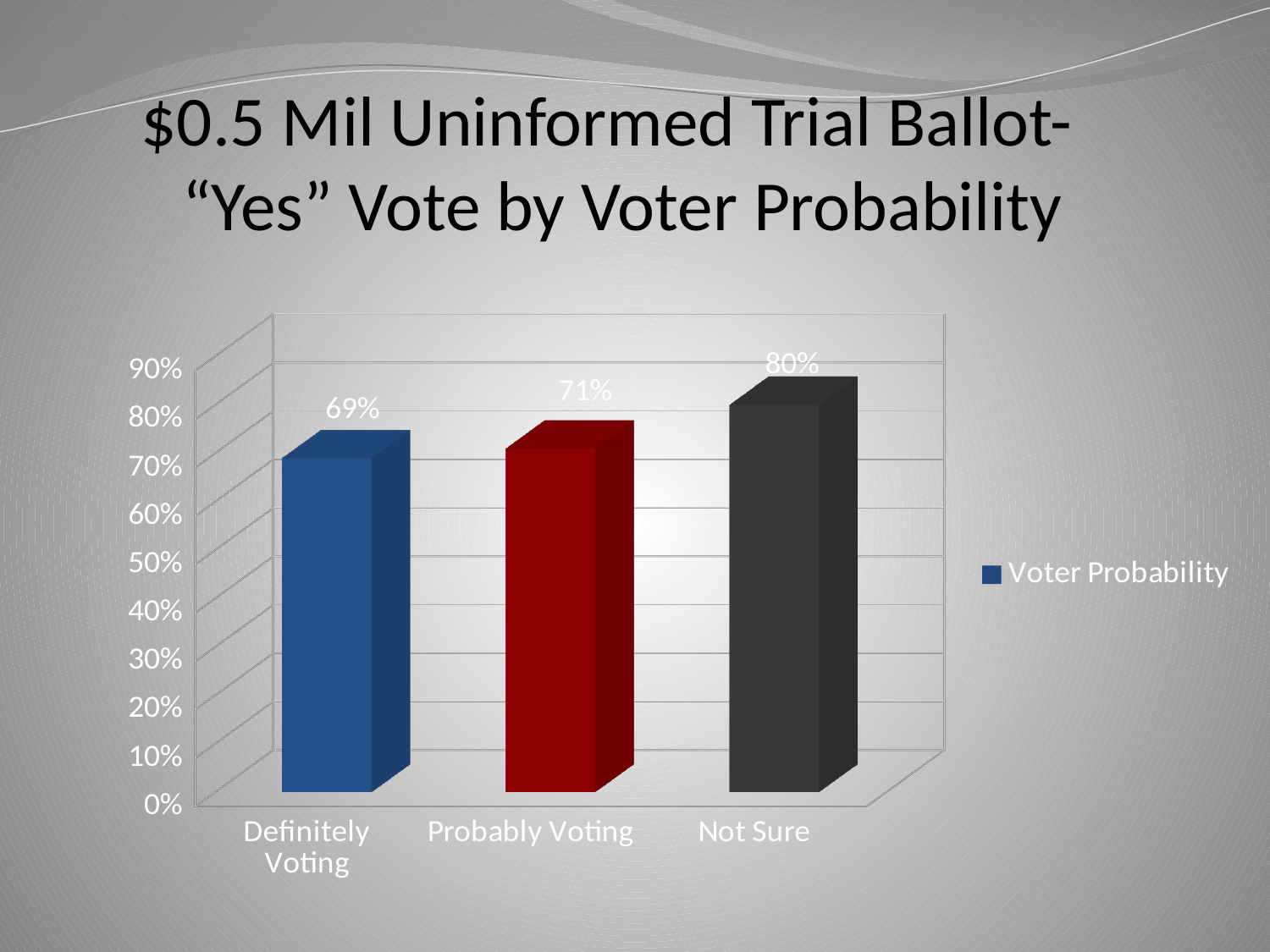
Which category has the highest value? Not Sure What is the difference between the values for Not Sure and Definitely Voting? 11% What is the value for Not Sure? 80% Is the value for Definitely Voting greater or less than 60%? greater What is the value for Definitely Voting? 69% Which category has the lowest value? Definitely Voting Do the values rise or fall from Definitely Voting to Not Sure? rise Which is larger, the value for Not Sure or the value for Probably Voting? Not Sure What kind of chart is shown on the slide? bar chart What is the difference between the values for Probably Voting and Definitely Voting? 2% What is the value for Probably Voting? 71% How many categories are shown on the x axis? 3